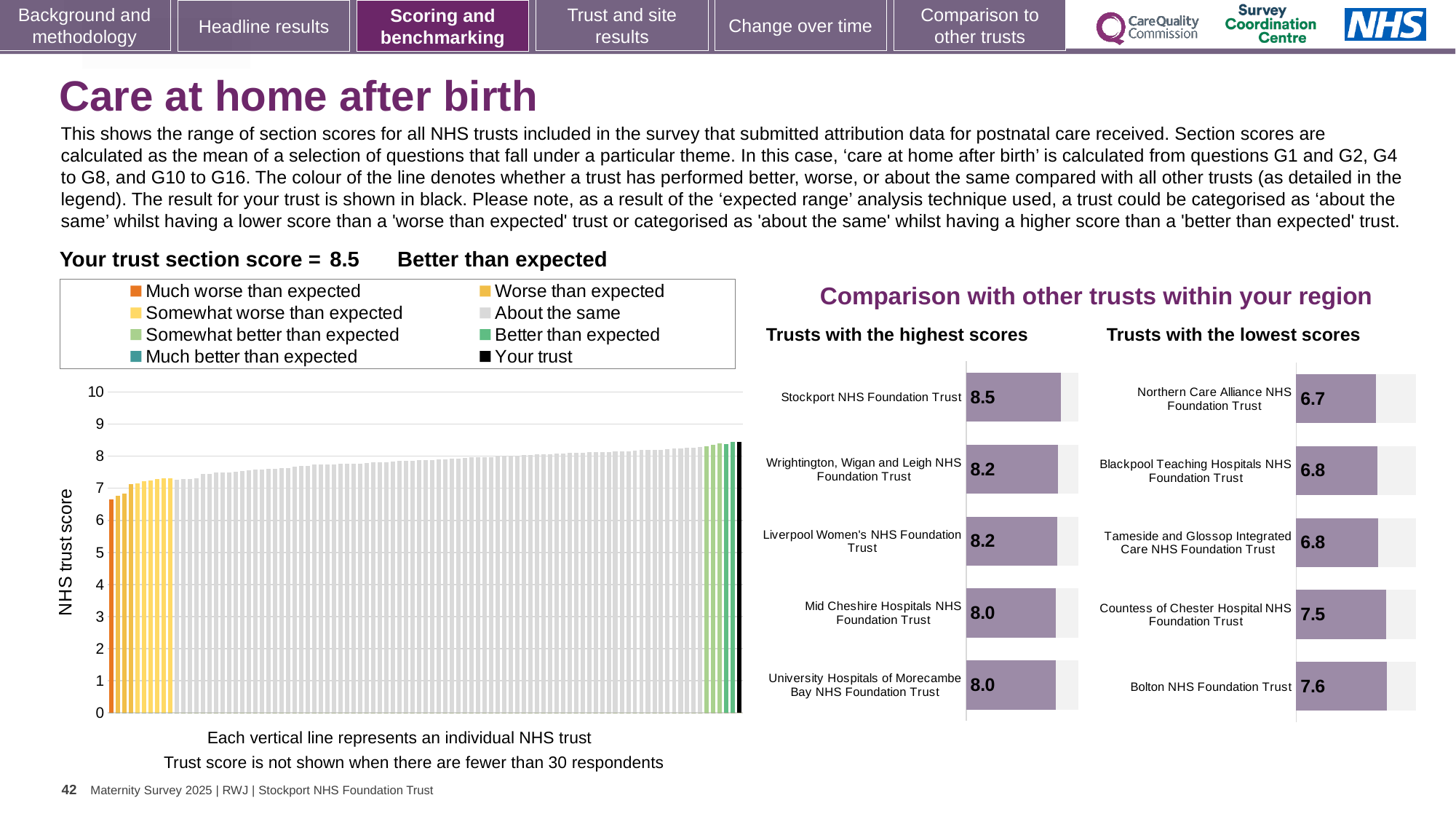
How many entries does the legend of the 'NHS trust score' chart on the left list? 8 In the 'NHS trust score' chart on the left, is the value of the black 'Your trust' bar greater or less than 8? greater In the 'Trusts with the highest scores' chart, what is the score for Stockport NHS Foundation Trust? 8.5 What kind of chart is the 'NHS trust score' chart on the left of the slide? Bar chart In the 'Trusts with the lowest scores' chart, what is the score for Bolton NHS Foundation Trust? 7.6 In the 'Trusts with the highest scores' chart, which trust has the highest score? Stockport NHS Foundation Trust How many trusts are shown in the 'Trusts with the lowest scores' chart? 5 In the 'Trusts with the highest scores' chart, what is the score for Mid Cheshire Hospitals NHS Foundation Trust? 8.0 In the 'Trusts with the highest scores' chart, what is the difference between the scores of Stockport NHS Foundation Trust and Wrightington, Wigan and Leigh NHS Foundation Trust? 0.3 In the 'Trusts with the lowest scores' chart, what is the score for Northern Care Alliance NHS Foundation Trust? 6.7 In the 'Trusts with the lowest scores' chart, which trust has the lowest score? Northern Care Alliance NHS Foundation Trust In the 'Trusts with the lowest scores' chart, which has the larger score: Countess of Chester Hospital NHS Foundation Trust or Blackpool Teaching Hospitals NHS Foundation Trust? Countess of Chester Hospital NHS Foundation Trust